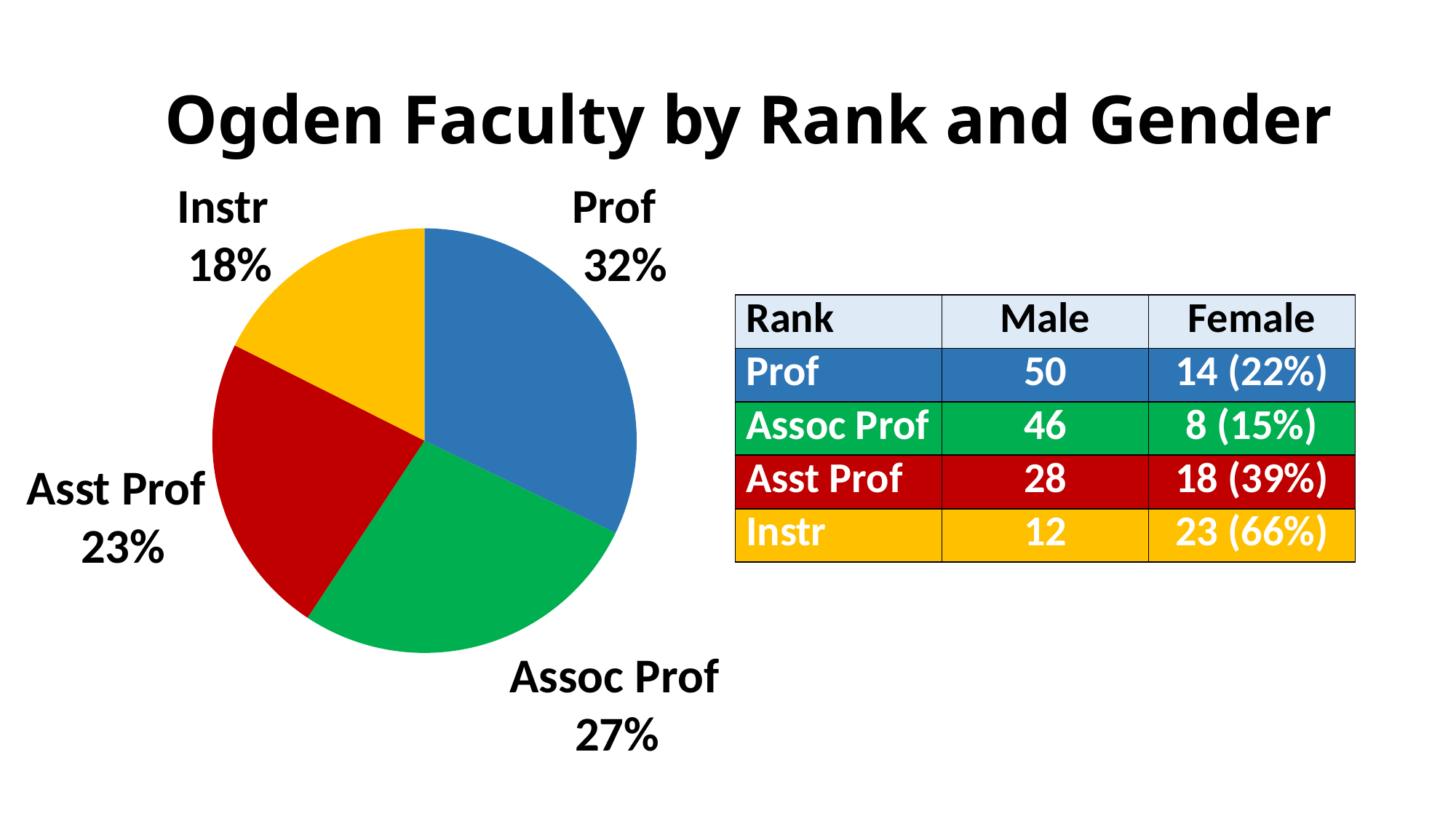
Which rank has the smallest slice of the pie? Instr Which slice is larger, Assoc Prof or Asst Prof? Assoc Prof What share of the pie does Asst Prof represent? 23% What colour is the Asst Prof slice of the pie? red What is the difference in percentage points between the Prof slice and the Instr slice? 14 How many slices does the pie chart have? 4 What share of the pie does Instr represent? 18% Which rank has the largest slice of the pie? Prof What share of the pie does Prof represent? 32% What is the title of the slide's chart? Ogden Faculty by Rank and Gender What kind of chart is shown on the slide? pie chart